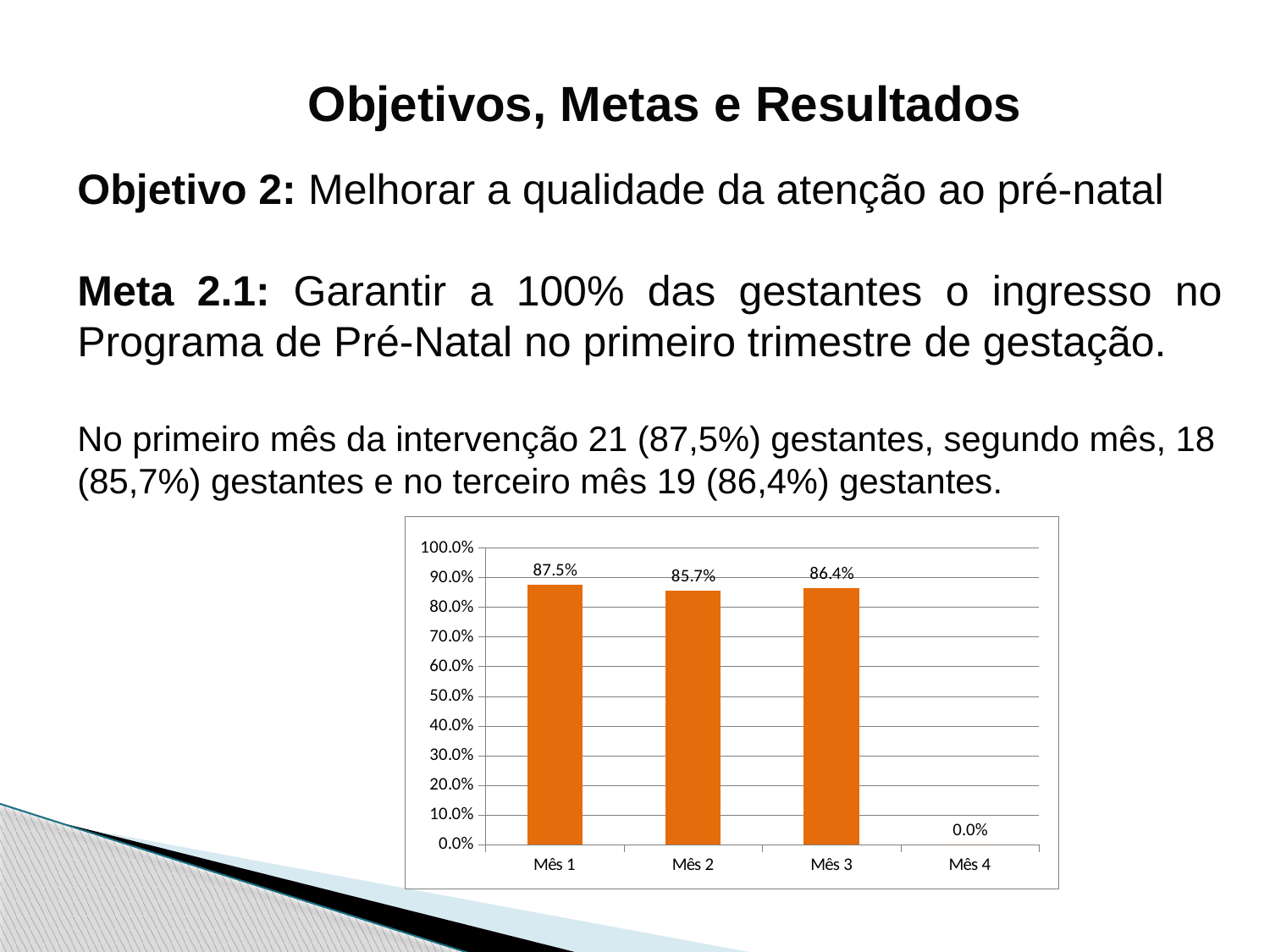
What is the difference between the values for Mês 1 and Mês 2? 1.8 percentage points Is the value for Mês 3 greater or less than 90.0%? less What is the value for Mês 3? 86.4% What is the value for Mês 1? 87.5% What kind of chart is shown on the slide? bar chart How many categories are shown on the x axis? 4 Which month has the highest value? Mês 1 What is the value for Mês 4? 0.0% What is the value for Mês 2? 85.7% What colour are the bars in the chart? orange Which month has the lowest value? Mês 4 Which is larger, the value for Mês 2 or the value for Mês 3? Mês 3